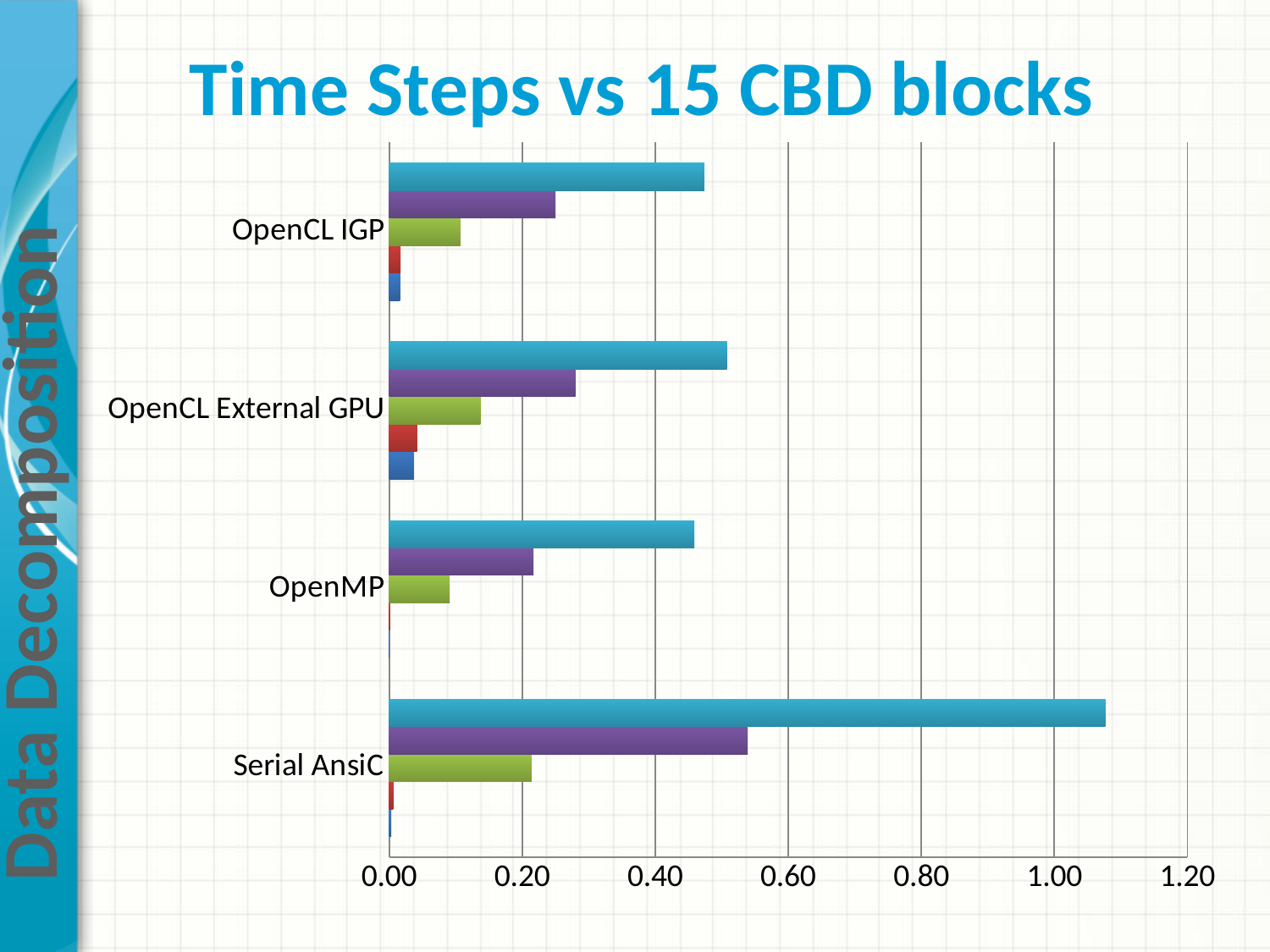
Is the value of the purple bar for OpenCL IGP greater or less than 0.20? greater What is the highest value shown on the horizontal axis of the chart? 1.20 Which has the larger teal (top) bar, Serial AnsiC or OpenCL IGP? Serial AnsiC Is the value of the teal (top) bar for Serial AnsiC greater or less than 1.00? greater Is the value of the teal (top) bar for OpenCL External GPU greater or less than 0.40? greater How many categories are shown on the vertical axis of the chart? 4 How many bars are plotted for each category in the chart? 5 What is the title of the chart? Time Steps vs 15 CBD blocks Which category has the longest teal (top) bar? Serial AnsiC What kind of chart is shown on the slide? bar chart